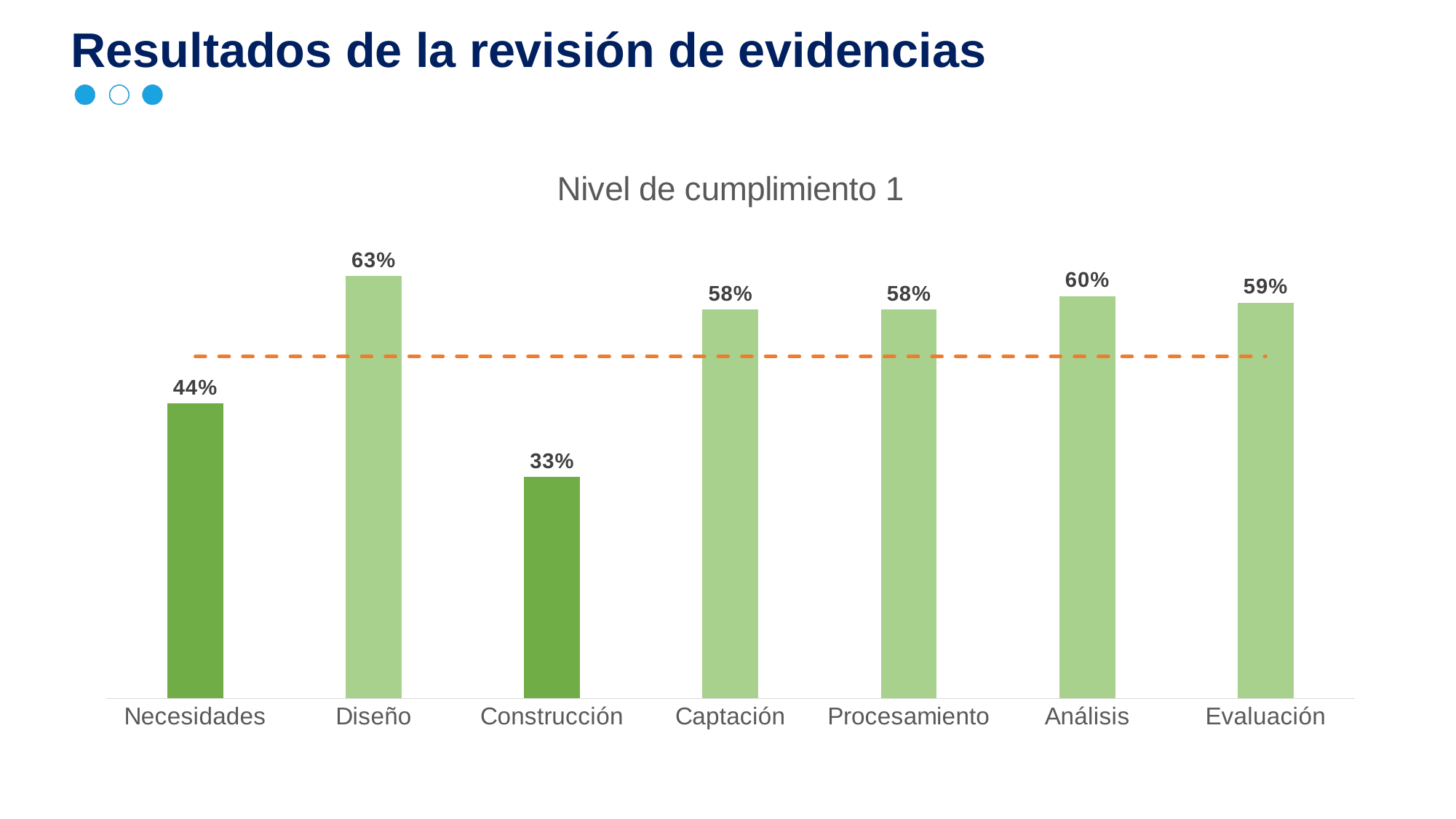
What is the difference between the values for Necesidades and Evaluación? 15% What kind of chart is shown on the slide? Bar chart What is the value for Análisis? 60% What is the value for Diseño? 63% Which two categories are drawn in a darker green than the others? Necesidades and Construcción How many categories are shown on the x axis? 7 Which category has the highest value? Diseño What is the value for Construcción? 33% What is the title of the chart? Nivel de cumplimiento 1 What is the difference between the values for Diseño and Construcción? 30% Which category has the lowest value? Construcción Which is larger, the value for Necesidades or the value for Captación? Captación